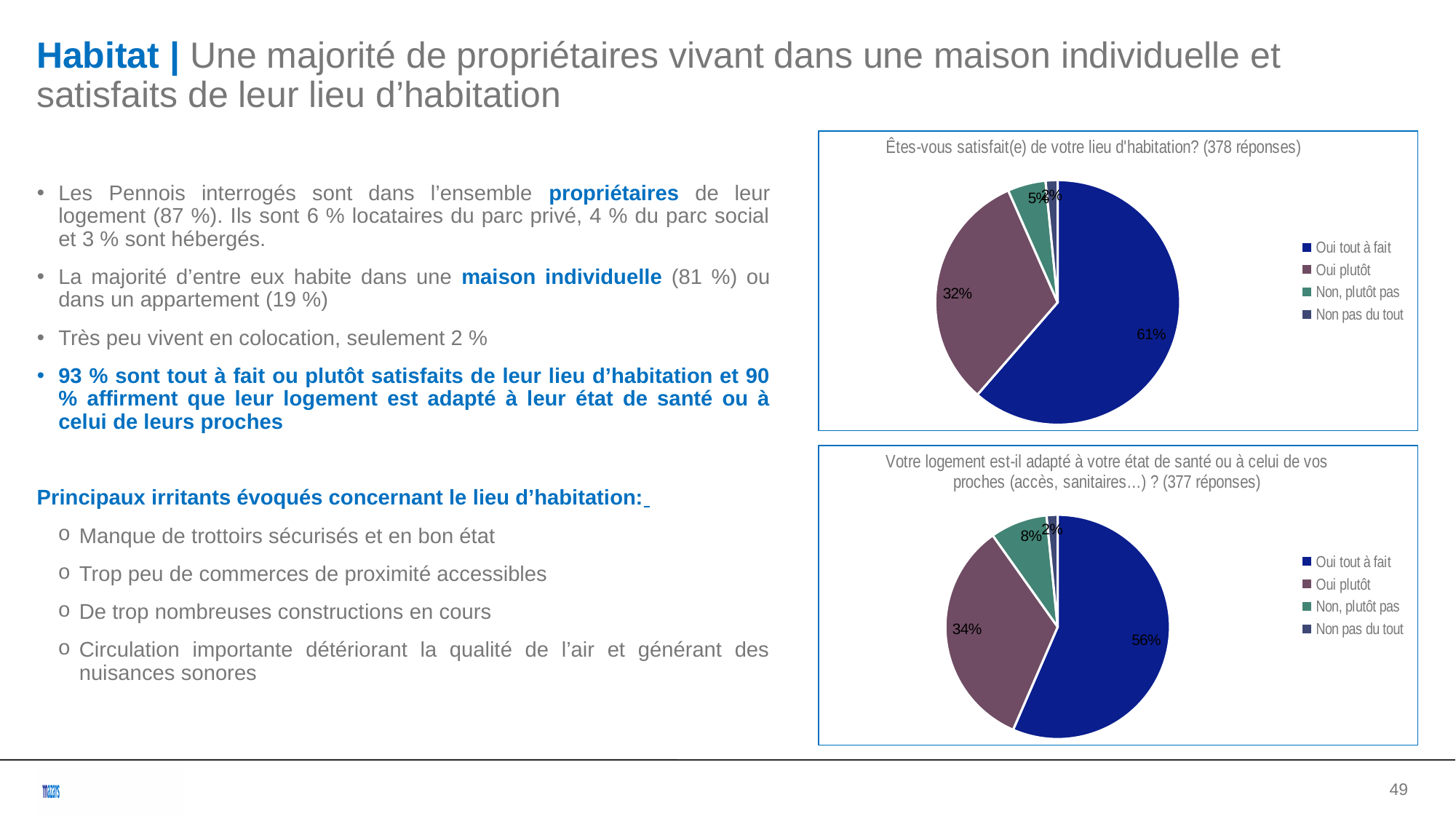
In the top chart 'Êtes-vous satisfait(e) de votre lieu d'habitation?', what share of responses is 'Oui tout à fait'? 61% In the bottom chart 'Votre logement est-il adapté à votre état de santé...', which response category has the smallest share? Non pas du tout What type of chart is used in the top chart 'Êtes-vous satisfait(e) de votre lieu d'habitation?'? Pie chart How many responses does the title of the bottom chart 'Votre logement est-il adapté à votre état de santé...' report? 377 réponses In the bottom chart 'Votre logement est-il adapté à votre état de santé...', what share of responses is 'Oui plutôt'? 34% Which is larger: the 'Oui tout à fait' share in the top chart or the 'Oui tout à fait' share in the bottom chart? The top chart (61%) In the top chart 'Êtes-vous satisfait(e) de votre lieu d'habitation?', what share of responses is 'Oui plutôt'? 32% In the bottom chart 'Votre logement est-il adapté à votre état de santé...', what share of responses is 'Non, plutôt pas'? 8% In the bottom chart 'Votre logement est-il adapté à votre état de santé...', what share of responses is 'Oui tout à fait'? 56% In the top chart 'Êtes-vous satisfait(e) de votre lieu d'habitation?', what is the difference in percentage points between 'Oui tout à fait' and 'Oui plutôt'? 29 percentage points How many response categories does the legend of the top chart 'Êtes-vous satisfait(e) de votre lieu d'habitation?' list? 4 In the top chart 'Êtes-vous satisfait(e) de votre lieu d'habitation?', which response category has the largest share? Oui tout à fait